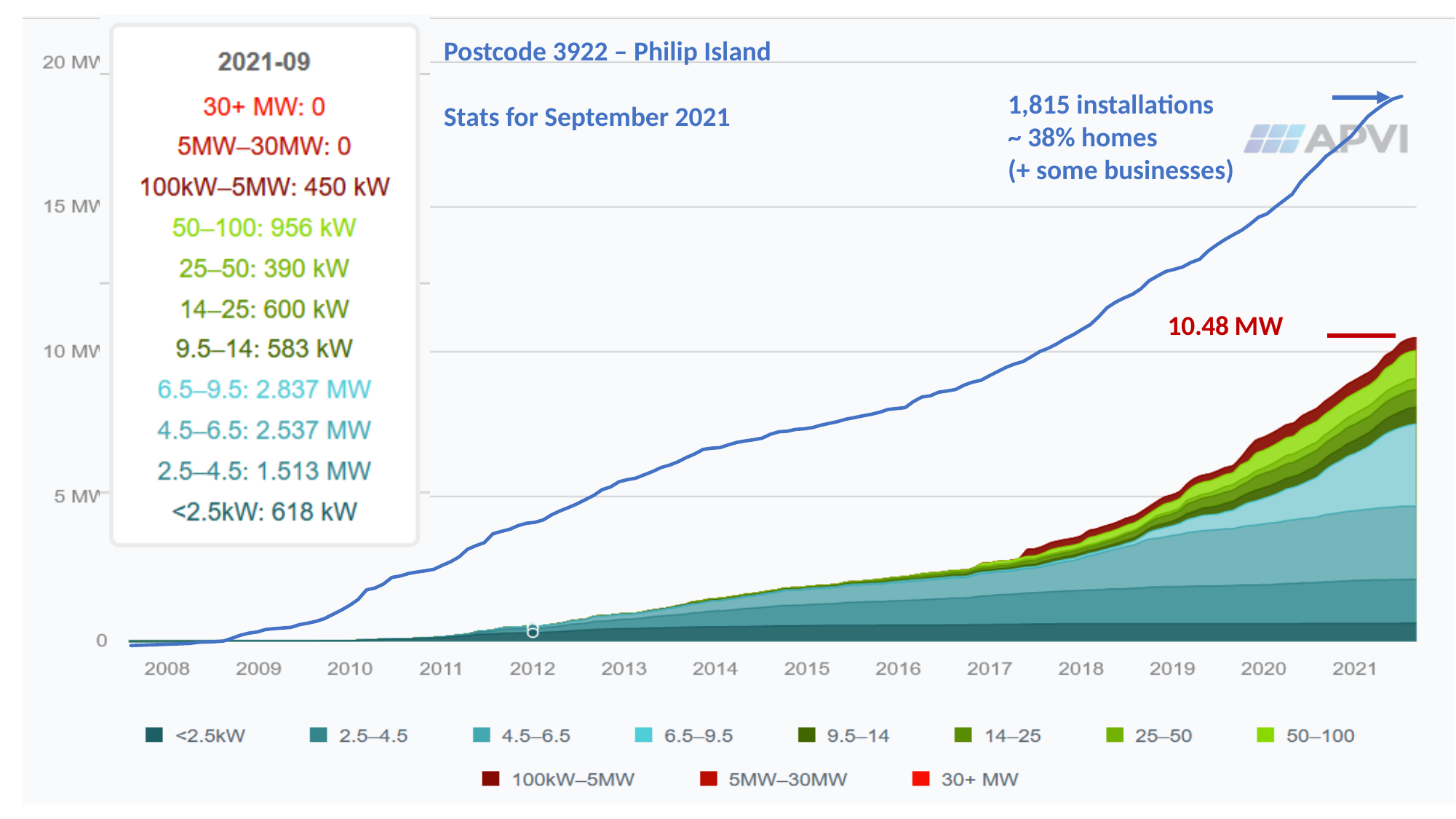
What is the difference between the 6.5–9.5 and 4.5–6.5 capacities in 2021-09? 0.300 MW How many series does the legend list? 11 Which has the larger capacity in 2021-09, the 14–25 band or the 25–50 band? 14–25 How many installations are stated for Postcode 3922? 1,815 What is the installed capacity for the <2.5kW size band in 2021-09? 618 kW What is the total installed capacity shown for September 2021? 10.48 MW What kind of chart is shown? Stacked area chart What is the installed capacity for the 100kW–5MW size band in 2021-09? 450 kW Is the total stacked capacity at the end of 2017 greater or less than 5 MW? less Does the total installed capacity rise or fall from 2008 to 2021? Rise Which size band has the largest installed capacity in 2021-09? 6.5–9.5 What is the installed capacity for the 6.5–9.5 size band in 2021-09? 2.837 MW